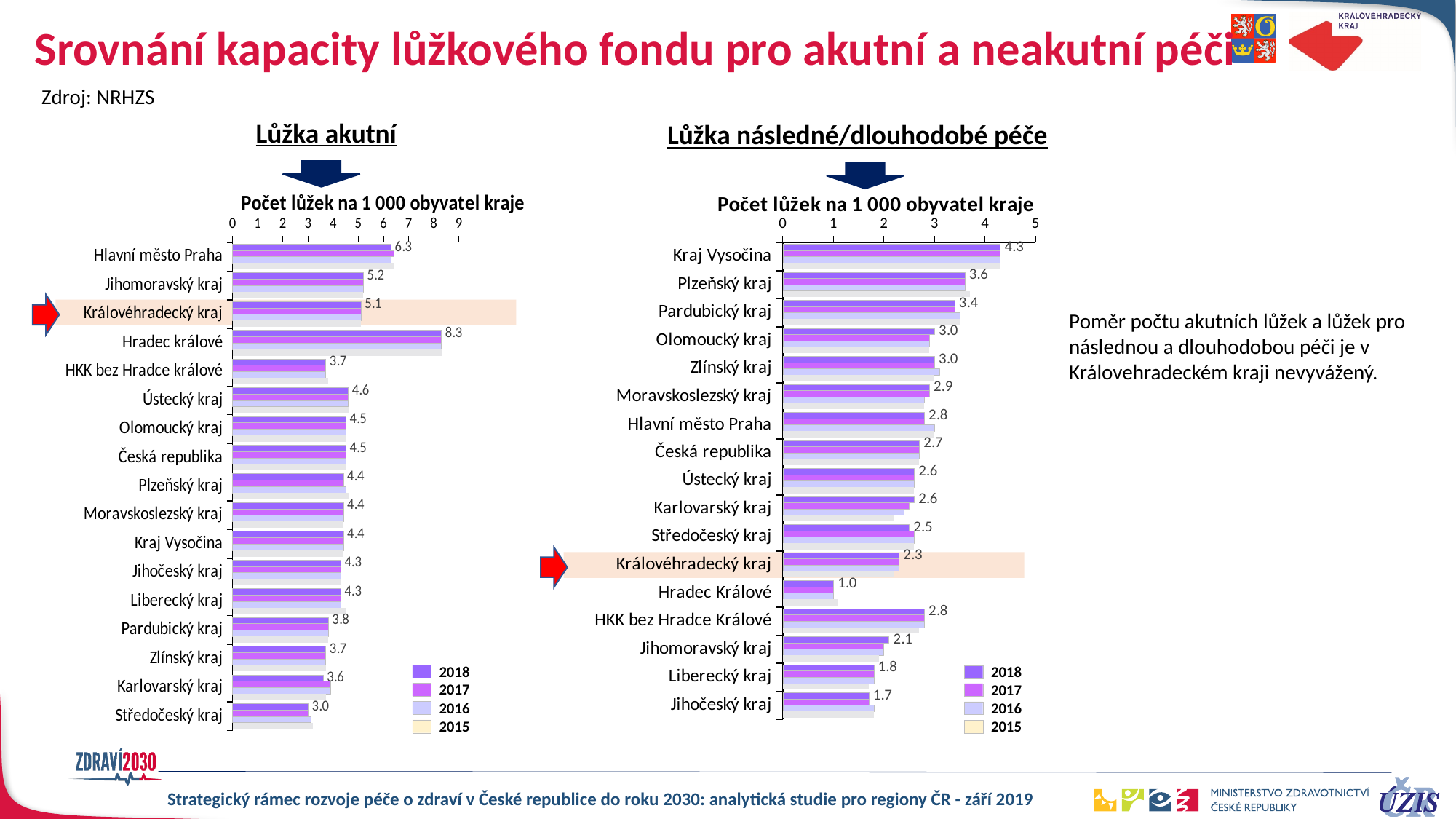
In the 'Lůžka akutní' chart, what is the difference between the labelled values for Hlavní město Praha and Středočeský kraj? 3.3 What kind of chart is the 'Lůžka akutní' chart? Bar chart In the 'Lůžka akutní' chart, which category has the lowest labelled value? Středočeský kraj In the 'Lůžka následné/dlouhodobé péče' chart, what is the difference between the labelled values for Kraj Vysočina and Královéhradecký kraj? 2.0 In the 'Lůžka akutní' chart, what is the labelled value for Královéhradecký kraj? 5.1 In the 'Lůžka následné/dlouhodobé péče' chart, which category has the lowest labelled value? Hradec Králové In the 'Lůžka akutní' chart, what is the labelled value for Hradec Králové? 8.3 In the 'Lůžka následné/dlouhodobé péče' chart, which has the larger labelled value: Plzeňský kraj or Pardubický kraj? Plzeňský kraj What is the axis title of the 'Lůžka následné/dlouhodobé péče' chart? Počet lůžek na 1 000 obyvatel kraje How many series does the legend of the 'Lůžka akutní' chart list? 4 In the 'Lůžka následné/dlouhodobé péče' chart, what is the labelled value for Kraj Vysočina? 4.3 How many categories are shown on the 'Lůžka následné/dlouhodobé péče' chart? 17